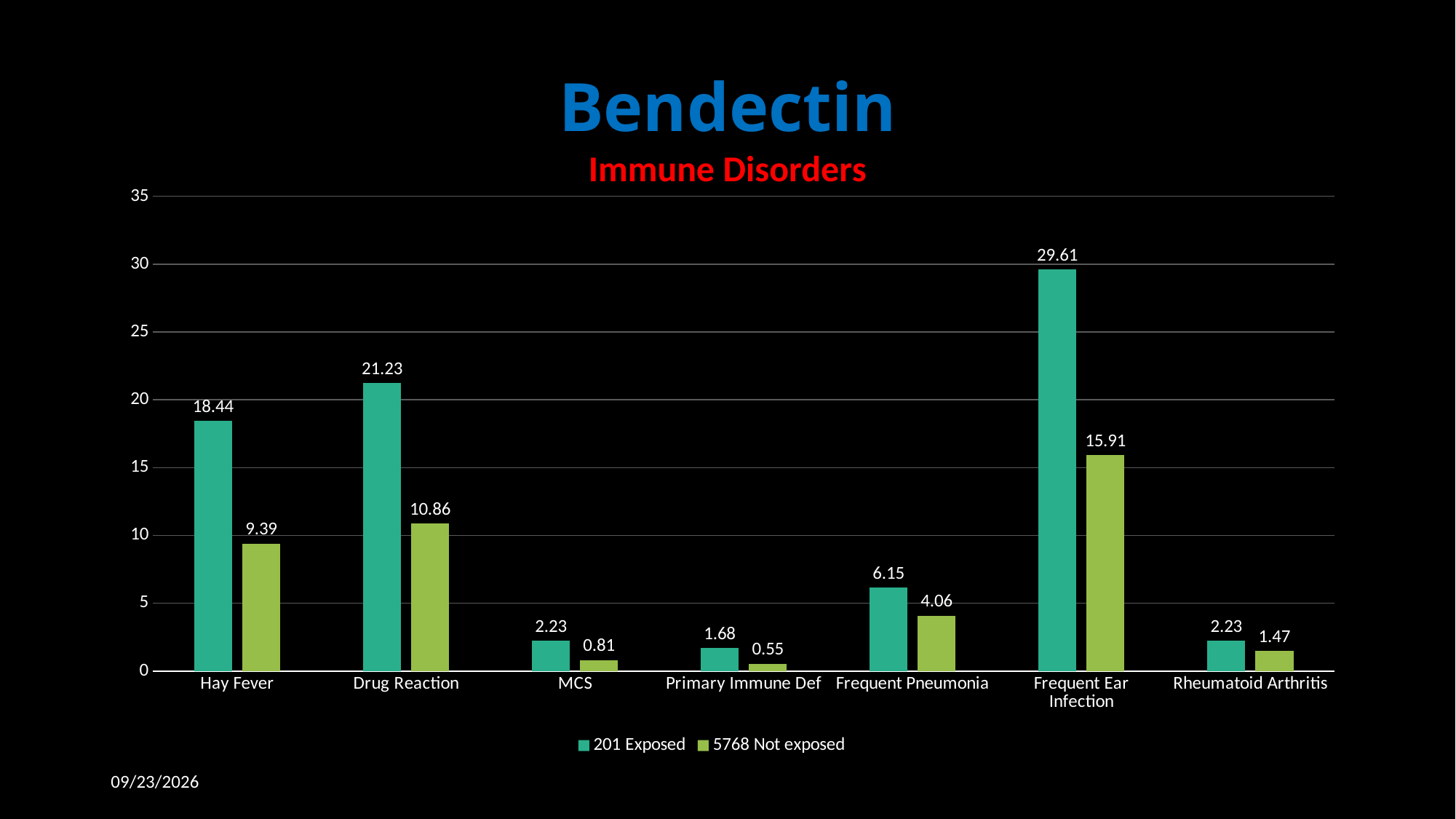
What is the value for Primary Immune Def in the 5768 Not exposed series? 0.55 What is the difference between the 201 Exposed and 5768 Not exposed values for Drug Reaction? 10.37 How many categories are shown on the x axis? 7 How many series does the legend list? 2 Which category has the highest value in the 201 Exposed series? Frequent Ear Infection What is the value for Hay Fever in the 201 Exposed series? 18.44 Which is larger for Frequent Pneumonia: the 201 Exposed value or the 5768 Not exposed value? 201 Exposed What is the value for Frequent Ear Infection in the 5768 Not exposed series? 15.91 What is the subtitle of the chart shown in red? Immune Disorders Which category has the lowest value in the 5768 Not exposed series? Primary Immune Def Is the 201 Exposed value for Drug Reaction greater or less than 20? greater What kind of chart is shown on the slide? Bar chart